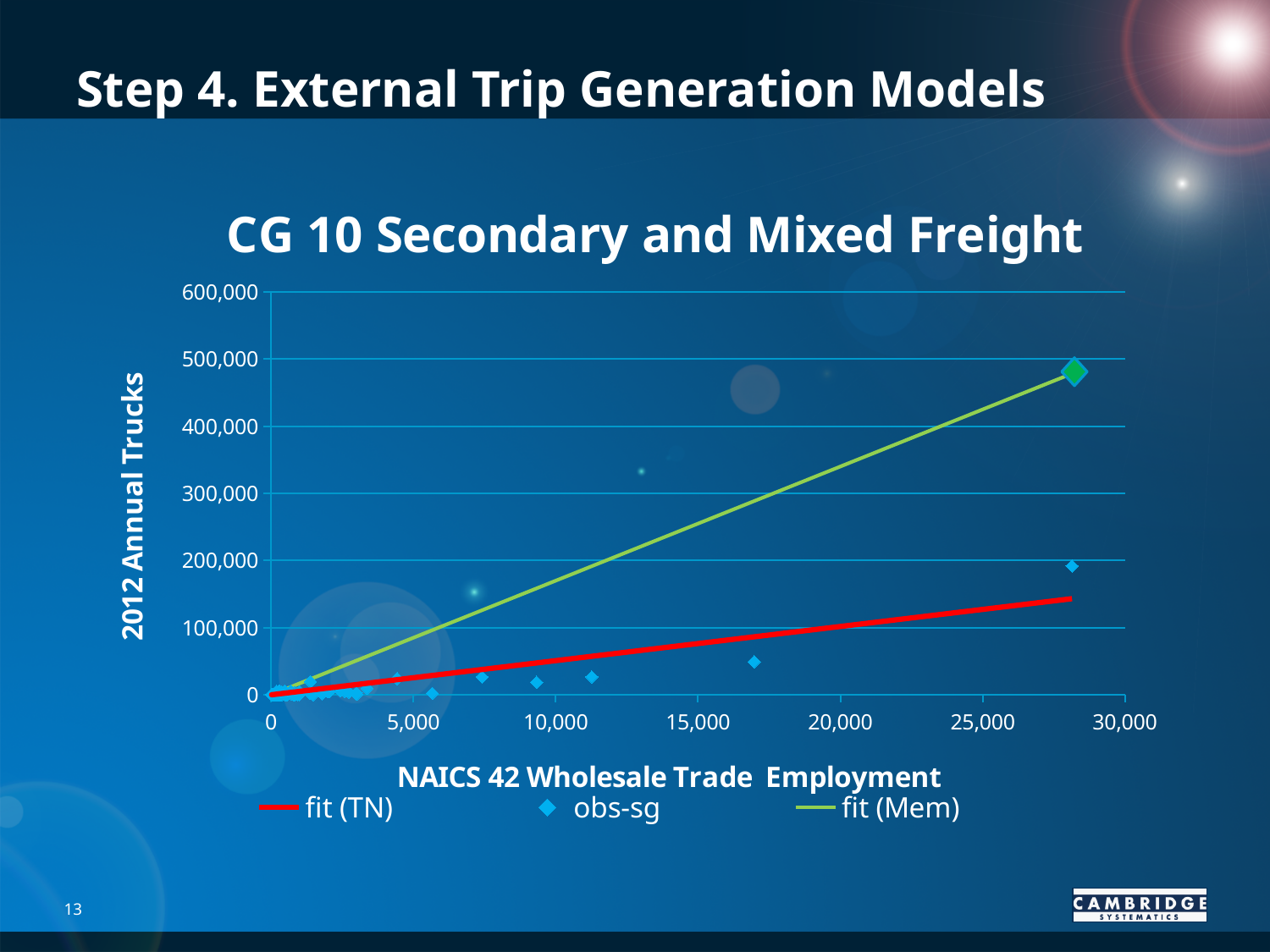
Which of the two fit lines is steeper? fit (Mem) What is the title of the chart? CG 10 Secondary and Mixed Freight Is the value of the fit (TN) line at its right-hand end (around 28,000 employment) greater or less than 100,000? greater At the right-hand end of the chart, which line is higher: fit (TN) or fit (Mem)? fit (Mem) What is the highest value shown on the vertical axis? 600,000 What kind of chart is shown on the slide? Scatter chart Is the obs-sg point near 17,000 employment greater or less than 100,000 annual trucks? less What is the label on the vertical axis of the chart? 2012 Annual Trucks Is the value of the fit (Mem) line at its right-hand end (around 28,000 employment) greater or less than 400,000? greater How many series does the chart legend list? 3 Do the fit lines rise or fall as NAICS 42 Wholesale Trade Employment increases? rise